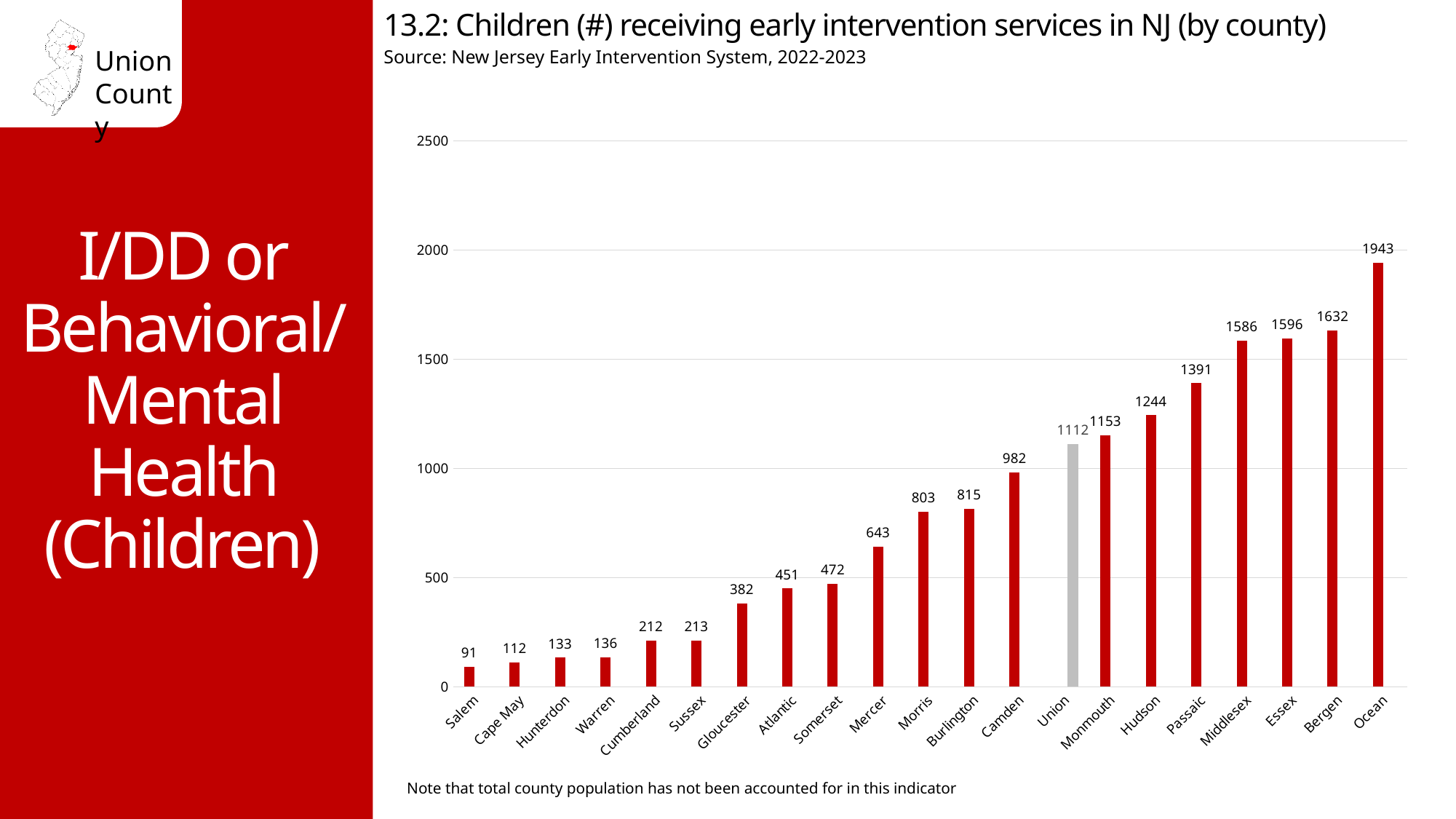
What kind of chart is shown on the slide? Bar chart Which county has the lowest number of children receiving early intervention services? Salem Is the value for Passaic greater or less than 1500? less Which county has the highest number of children receiving early intervention services? Ocean What is the difference between the values for Bergen and Essex? 36 What is the difference between the values for Union and Monmouth? 41 Which county has a larger value, Camden or Hudson? Hudson How many counties are shown on the chart? 21 How many children are receiving early intervention services in Union County? 1112 Which county's bar is shown in gray rather than red? Union What is the value shown for Ocean County? 1943 What is the value shown for Mercer County? 643